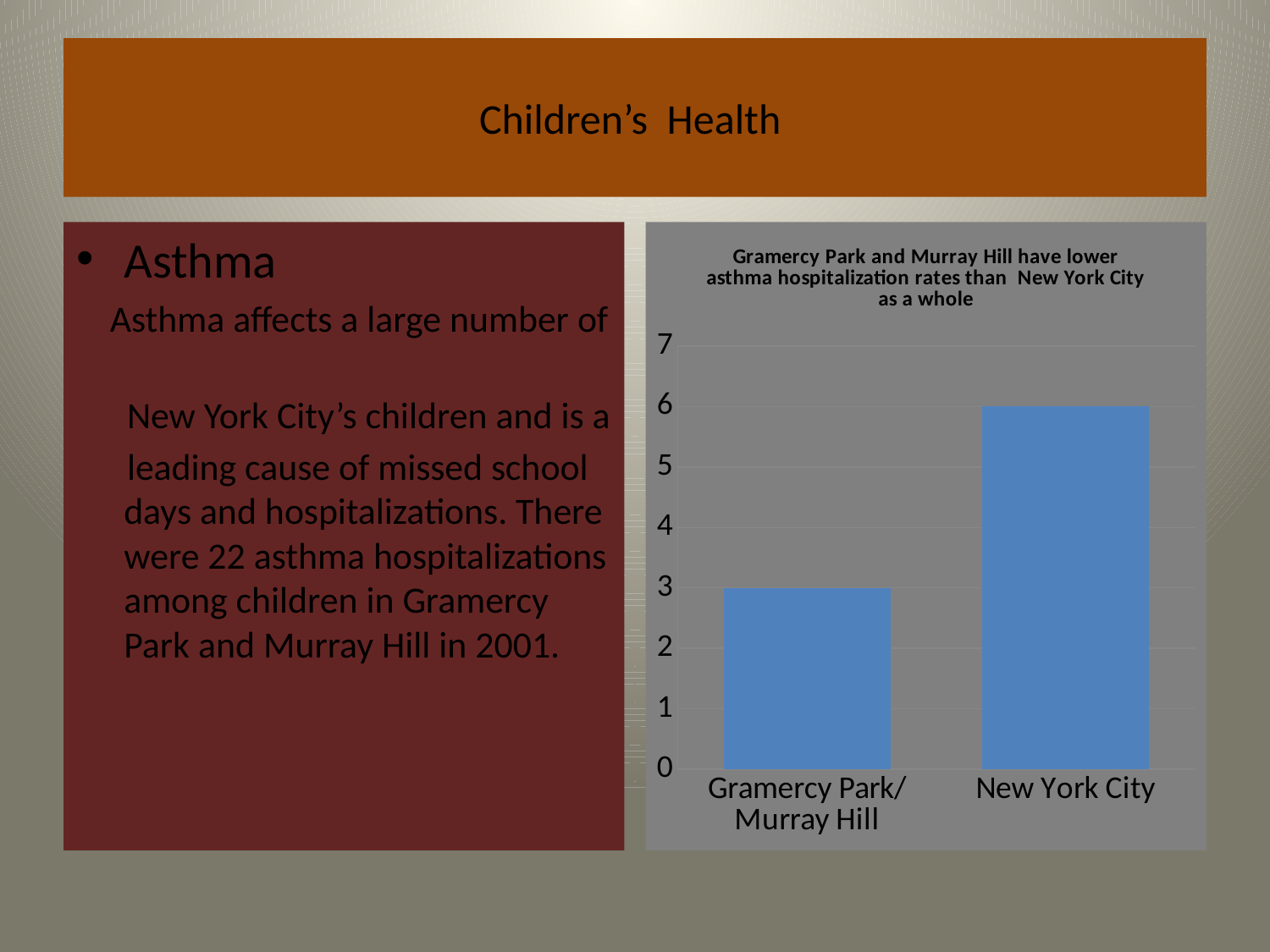
What is the difference between the values for New York City and Gramercy Park/Murray Hill? 3 Is the value for Gramercy Park/Murray Hill greater or less than 4? less Which category has the highest value? New York City How many categories are plotted in the chart? 2 What type of chart is shown on the slide? bar chart Which is larger, the value for Gramercy Park/Murray Hill or the value for New York City? New York City What is the title of the chart? Gramercy Park and Murray Hill have lower asthma hospitalization rates than New York City as a whole What is the value for New York City? 6 What is the highest value shown on the vertical axis? 7 What is the value for Gramercy Park/Murray Hill? 3 Is the value for New York City greater or less than 5? greater Which category has the lowest value? Gramercy Park/Murray Hill